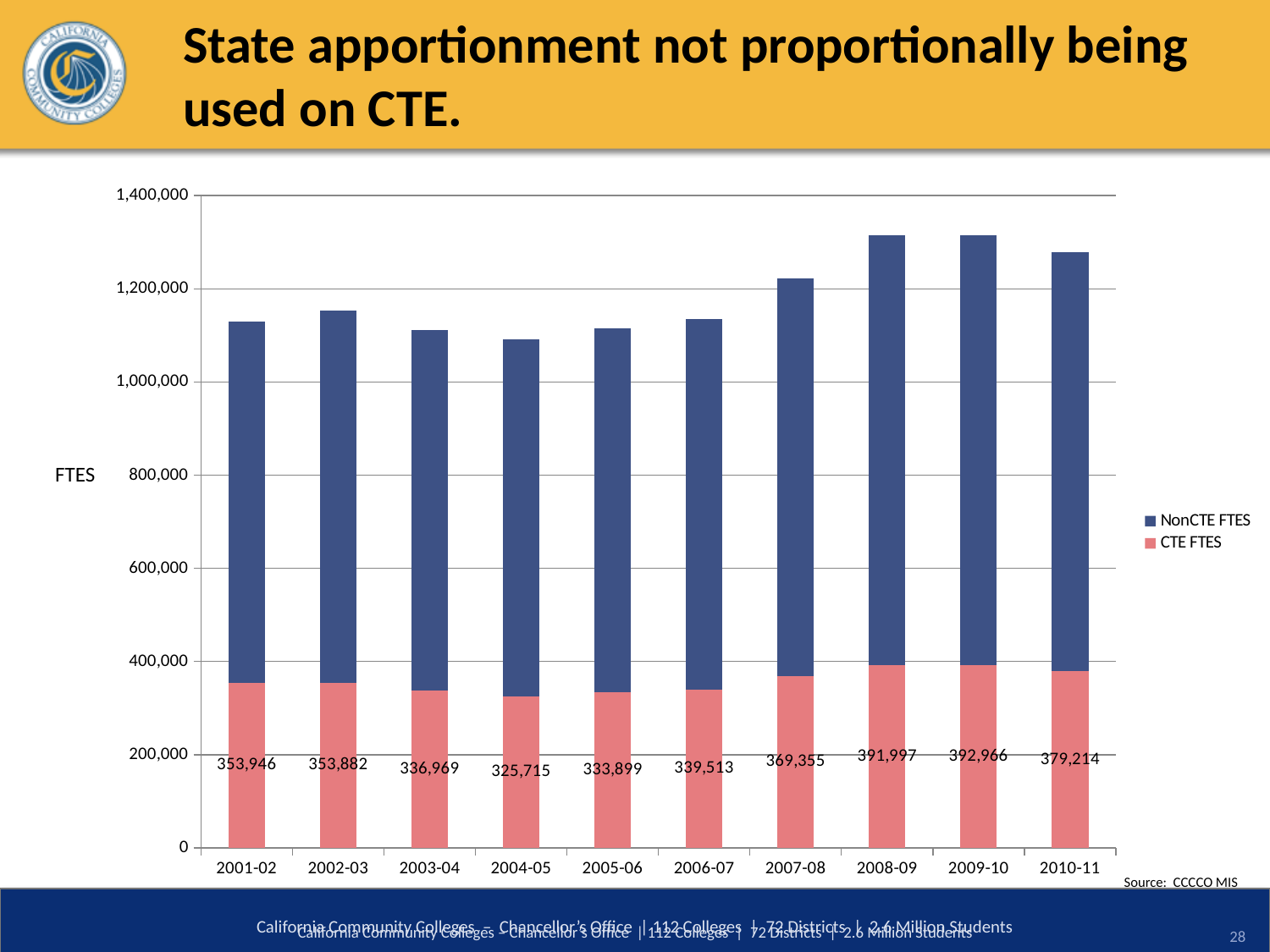
What is the CTE FTES value for 2001-02? 353,946 What is the CTE FTES value for 2010-11? 379,214 Which year has the lowest CTE FTES value? 2004-05 How many academic years are shown on the x axis? 10 What kind of chart is shown on the slide? Stacked bar chart Is the total height of the stacked bar for 2008-09 greater or less than 1,200,000? greater Which year has the highest CTE FTES value? 2009-10 How many series does the legend list? 2 Is the total height of the stacked bar for 2004-05 greater or less than 1,200,000? less What is the difference between the CTE FTES values for 2010-11 and 2001-02? 25,268 Which is larger, the CTE FTES value for 2007-08 or for 2006-07? 2007-08 What is the CTE FTES value for 2009-10? 392,966